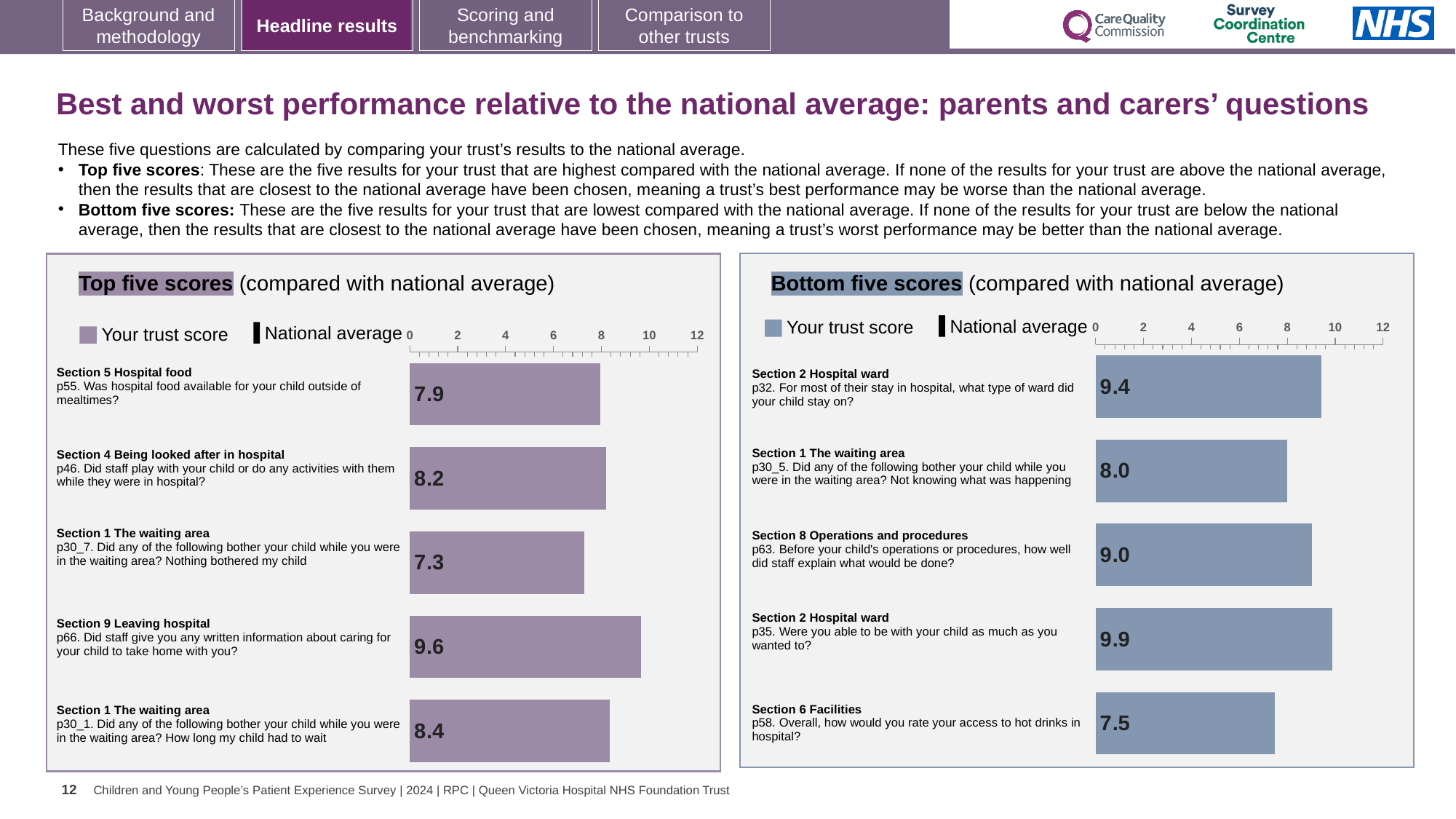
In the 'Top five scores' chart, what is the trust score for p55 (Was hospital food available for your child outside of mealtimes?)? 7.9 In the 'Top five scores' chart, what is the trust score for p66 (Did staff give you any written information about caring for your child to take home with you?)? 9.6 In the 'Top five scores' chart, what is the difference between the trust scores for p66 and p30_7? 2.3 In the 'Bottom five scores' chart, what is the trust score for p30_5 (Not knowing what was happening)? 8.0 In the 'Bottom five scores' chart, which question has the lowest trust score? p58. Overall, how would you rate your access to hot drinks in hospital? What type of chart is the 'Top five scores' chart? Bar chart How many questions are plotted in the 'Bottom five scores' chart? 5 In the 'Top five scores' chart, which question has the lowest trust score? p30_7. Did any of the following bother your child while you were in the waiting area? Nothing bothered my child In the 'Bottom five scores' chart, which has the larger trust score: p32 (what type of ward did your child stay on?) or p63 (how well did staff explain what would be done?)? p32 In the 'Bottom five scores' chart, what is the trust score for p58 (Overall, how would you rate your access to hot drinks in hospital?)? 7.5 In the 'Bottom five scores' chart, which question has the highest trust score? p35. Were you able to be with your child as much as you wanted to? In the 'Top five scores' chart, which question has the highest trust score? p66. Did staff give you any written information about caring for your child to take home with you?